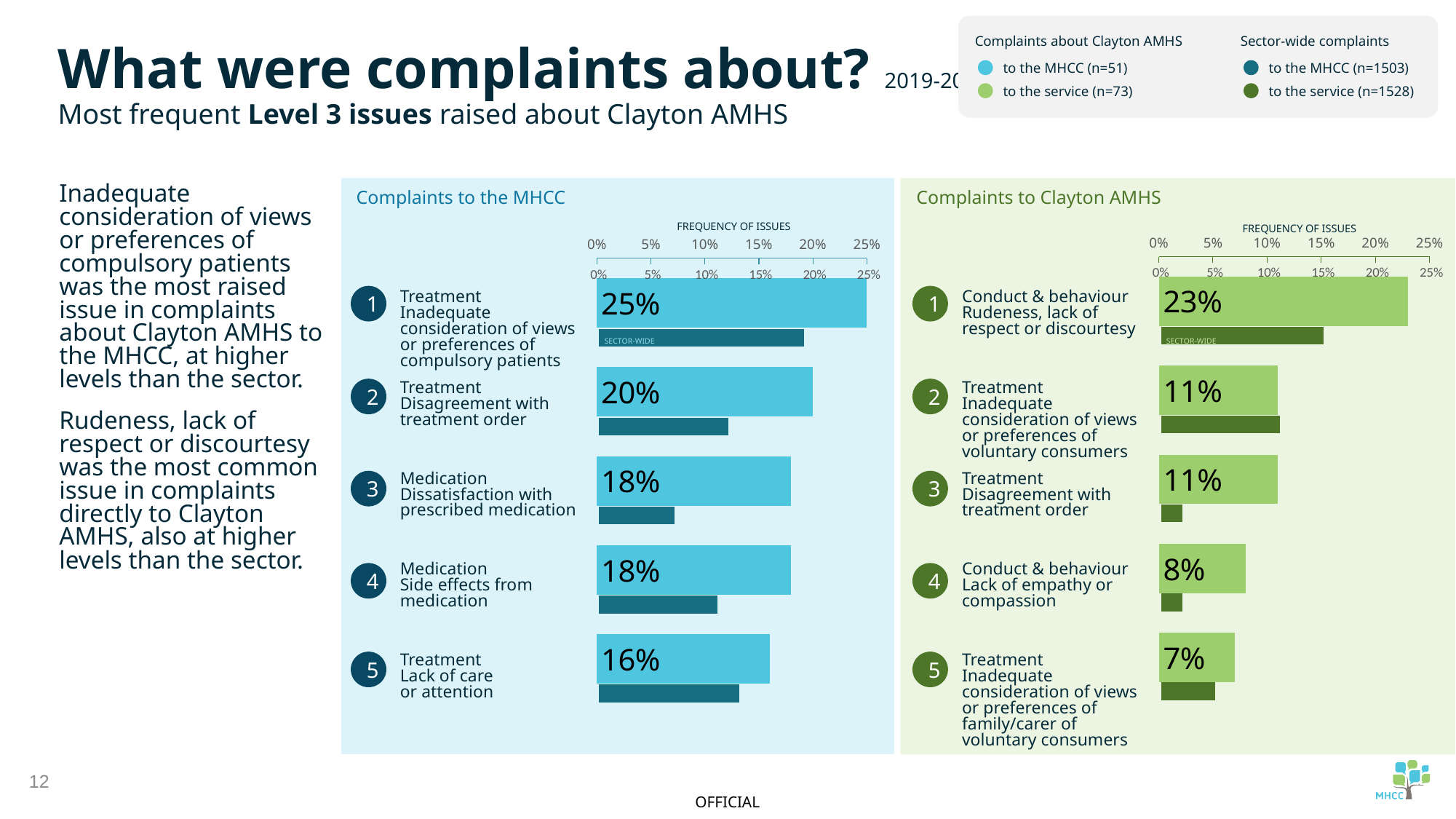
In the 'Complaints to the MHCC' chart, what is the difference between the value for 'Treatment – Disagreement with treatment order' and 'Treatment – Lack of care or attention'? 4% In the 'Complaints to the MHCC' chart, what is the value for 'Treatment – Inadequate consideration of views or preferences of compulsory patients'? 25% In the 'Complaints to the MHCC' chart, what is the value for 'Medication – Dissatisfaction with prescribed medication'? 18% What kind of chart is used in the 'Complaints to Clayton AMHS' panel? Bar chart In the 'Complaints to Clayton AMHS' chart, what is the value for 'Conduct & behaviour – Rudeness, lack of respect or discourtesy'? 23% In the 'Complaints to Clayton AMHS' chart, what is the value for 'Conduct & behaviour – Lack of empathy or compassion'? 8% How many issues are listed in the 'Complaints to the MHCC' chart? 5 In the 'Complaints to the MHCC' chart, which issue has the highest frequency? Treatment – Inadequate consideration of views or preferences of compulsory patients In the 'Complaints to Clayton AMHS' chart, which issue has the lowest frequency? Treatment – Inadequate consideration of views or preferences of family/carer of voluntary consumers In the 'Complaints to Clayton AMHS' chart, what is the difference between the top issue (23%) and the second issue (11%)? 12% In the 'Complaints to the MHCC' chart, is the sector-wide bar for 'Medication – Dissatisfaction with prescribed medication' greater or less than 10%? less In the 'Complaints to Clayton AMHS' chart, is the sector-wide bar for 'Conduct & behaviour – Rudeness, lack of respect or discourtesy' greater or less than 10%? greater